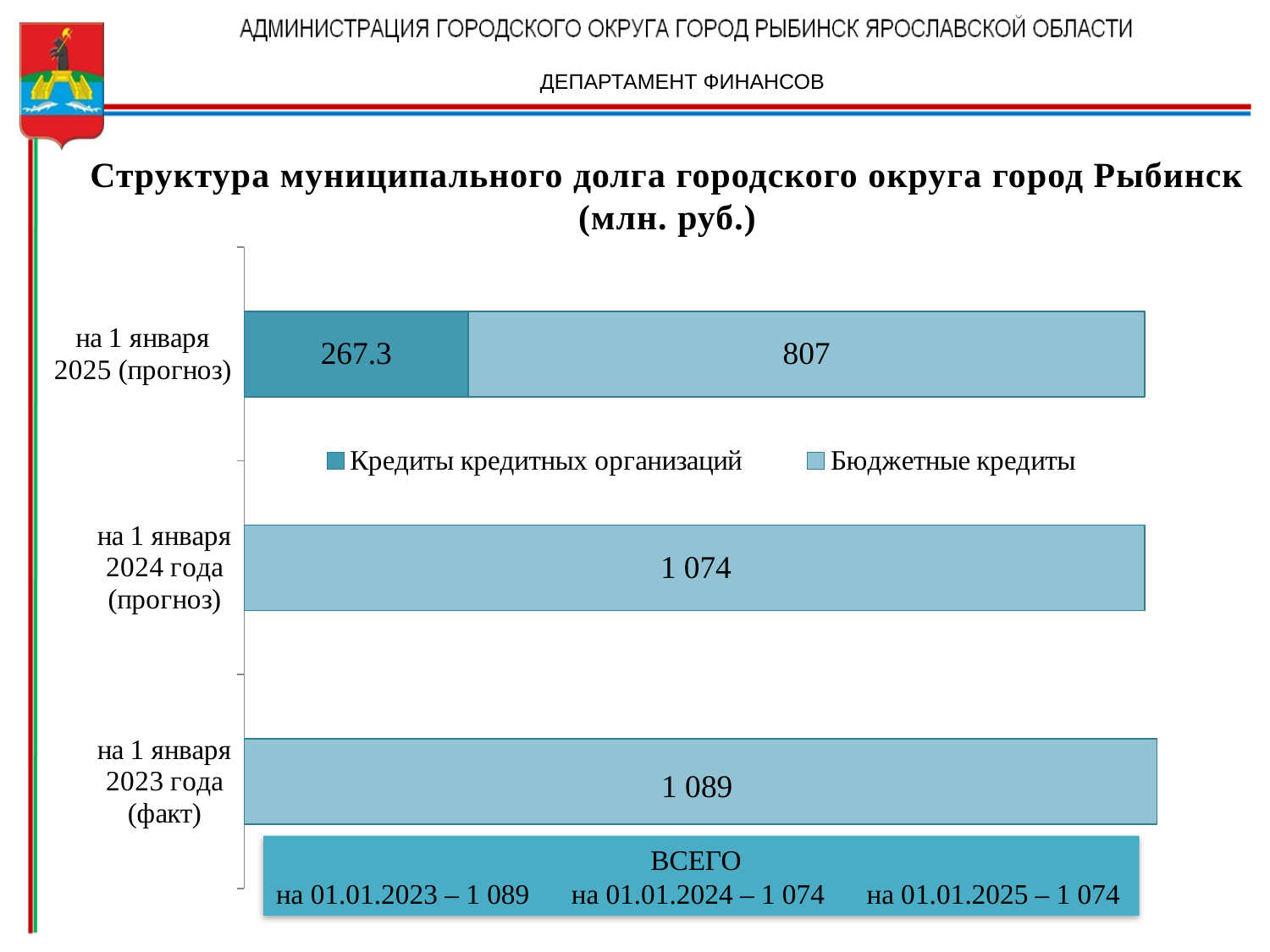
What is the value of Кредиты кредитных организаций for на 1 января 2025 (прогноз)? 267.3 What is the value of Бюджетные кредиты for на 1 января 2025 (прогноз)? 807 What is the value shown for на 1 января 2024 года (прогноз)? 1 074 For which date is the Бюджетные кредиты value the lowest? на 1 января 2025 (прогноз) What is the value shown for на 1 января 2023 года (факт)? 1 089 What kind of chart is shown on the slide? Stacked bar chart How many dates (categories) are shown in the chart? 3 For which date is the Бюджетные кредиты value the highest? на 1 января 2023 года (факт) Do the Бюджетные кредиты values rise or fall from 1 January 2023 to 1 January 2025? Fall For на 1 января 2025 (прогноз), which is larger: Кредиты кредитных организаций or Бюджетные кредиты? Бюджетные кредиты How many series does the legend list? 2 What is the difference between the values for на 1 января 2023 года (факт) and на 1 января 2024 года (прогноз)? 15